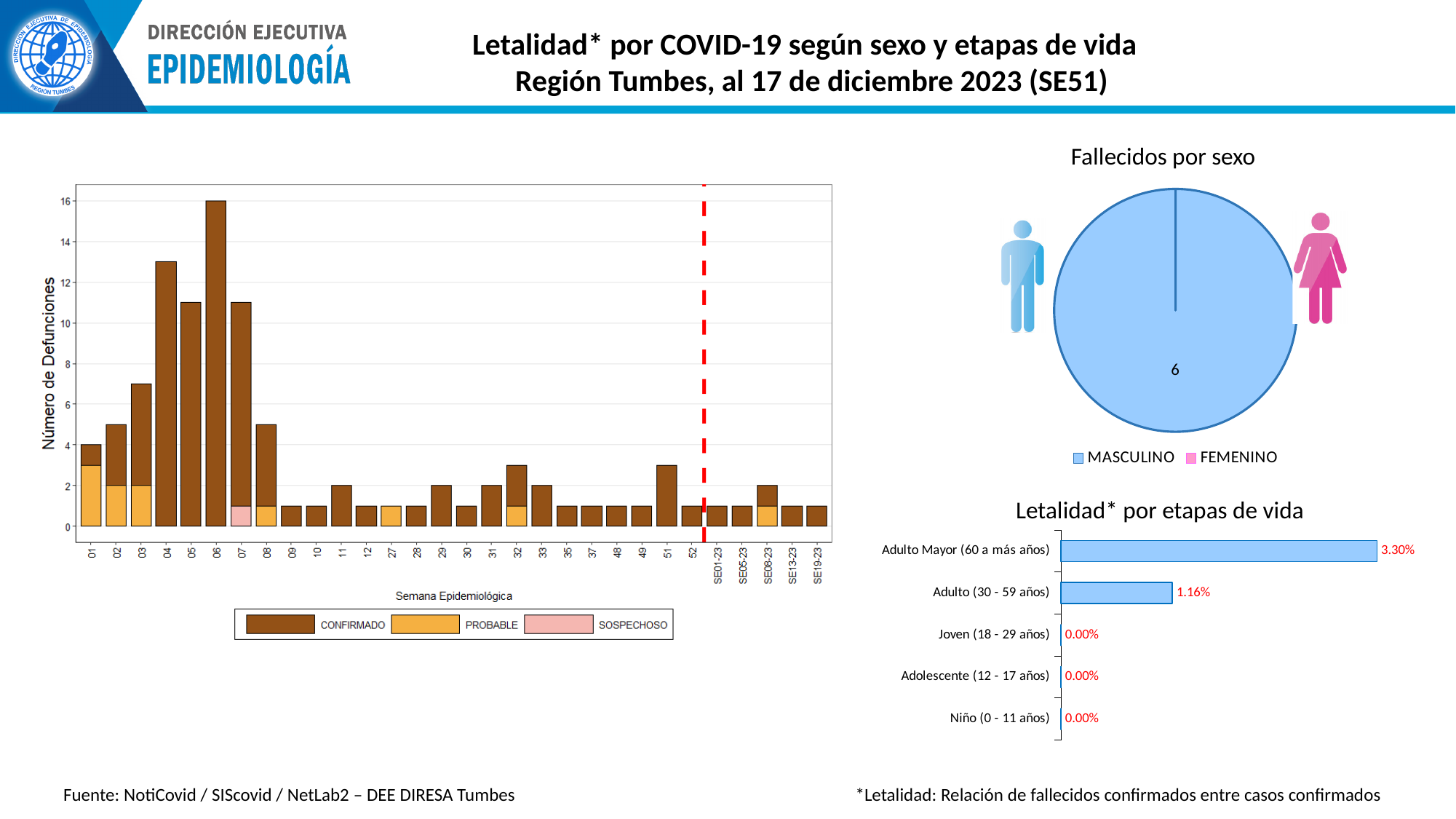
In the 'Letalidad* por etapas de vida' chart, how many age groups are shown? 5 In the left chart of deaths by epidemiological week, how many series does the legend list? 3 In the 'Letalidad* por etapas de vida' chart, what is the difference between the values for Adulto Mayor (60 a más años) and Adulto (30 - 59 años)? 2.14% In the 'Letalidad* por etapas de vida' chart, what is the value for Adulto Mayor (60 a más años)? 3.30% In the 'Fallecidos por sexo' pie chart, what value is shown for MASCULINO? 6 In the 'Fallecidos por sexo' pie chart, how many entries does the legend list? 2 In the 'Letalidad* por etapas de vida' chart, which age group has the highest value? Adulto Mayor (60 a más años) In the left chart of deaths by epidemiological week, is the total for week 04 greater or less than 12? greater In the left chart of deaths by epidemiological week, which week has the highest number of deaths? 06 In the 'Letalidad* por etapas de vida' chart, what is the value for Joven (18 - 29 años)? 0.00% In the 'Letalidad* por etapas de vida' chart, what is the value for Adulto (30 - 59 años)? 1.16% What kind of chart is 'Fallecidos por sexo'? Pie chart